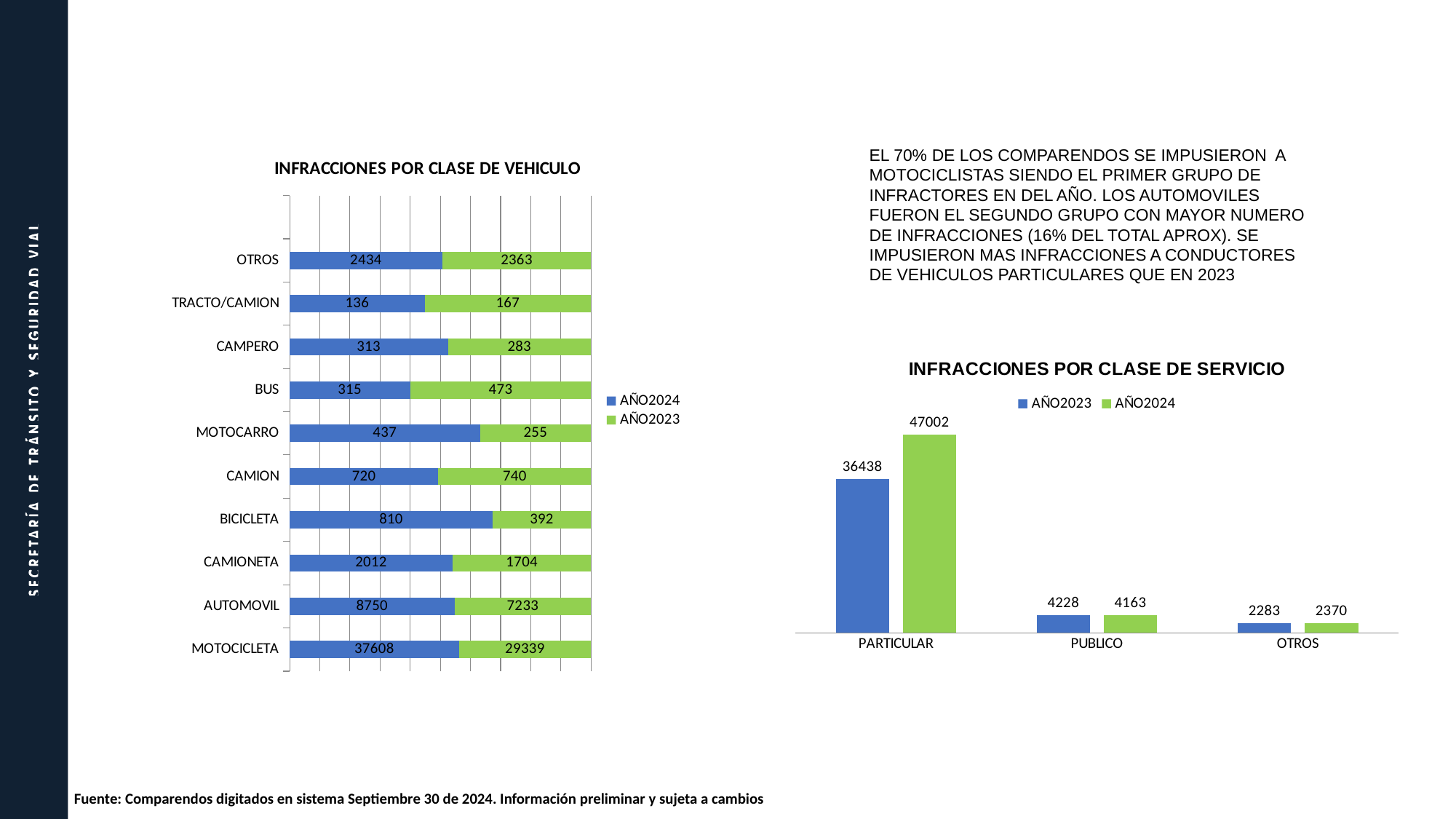
In the chart titled INFRACCIONES POR CLASE DE VEHICULO, which category has the highest AÑO2024 value? MOTOCICLETA In the chart titled INFRACCIONES POR CLASE DE VEHICULO, what is the total of the two values shown for BUS? 788 In the chart titled INFRACCIONES POR CLASE DE VEHICULO, which category has the lowest AÑO2024 value? TRACTO/CAMION In the chart titled INFRACCIONES POR CLASE DE SERVICIO, how many series does the legend list? 2 What kind of chart is the chart titled INFRACCIONES POR CLASE DE SERVICIO? Bar chart In the chart titled INFRACCIONES POR CLASE DE VEHICULO, what is the difference between the AÑO2024 and AÑO2023 values for CAMIONETA? 308 In the chart titled INFRACCIONES POR CLASE DE VEHICULO, what is the AÑO2024 value for MOTOCICLETA? 37608 In the chart titled INFRACCIONES POR CLASE DE SERVICIO, which is larger for PUBLICO, AÑO2023 or AÑO2024? AÑO2023 In the chart titled INFRACCIONES POR CLASE DE SERVICIO, what is the AÑO2024 value for PARTICULAR? 47002 In the chart titled INFRACCIONES POR CLASE DE SERVICIO, what is the difference between the AÑO2024 and AÑO2023 values for PARTICULAR? 10564 In the chart titled INFRACCIONES POR CLASE DE VEHICULO, what is the AÑO2023 value for AUTOMOVIL? 7233 In the chart titled INFRACCIONES POR CLASE DE VEHICULO, how many vehicle categories are shown? 10